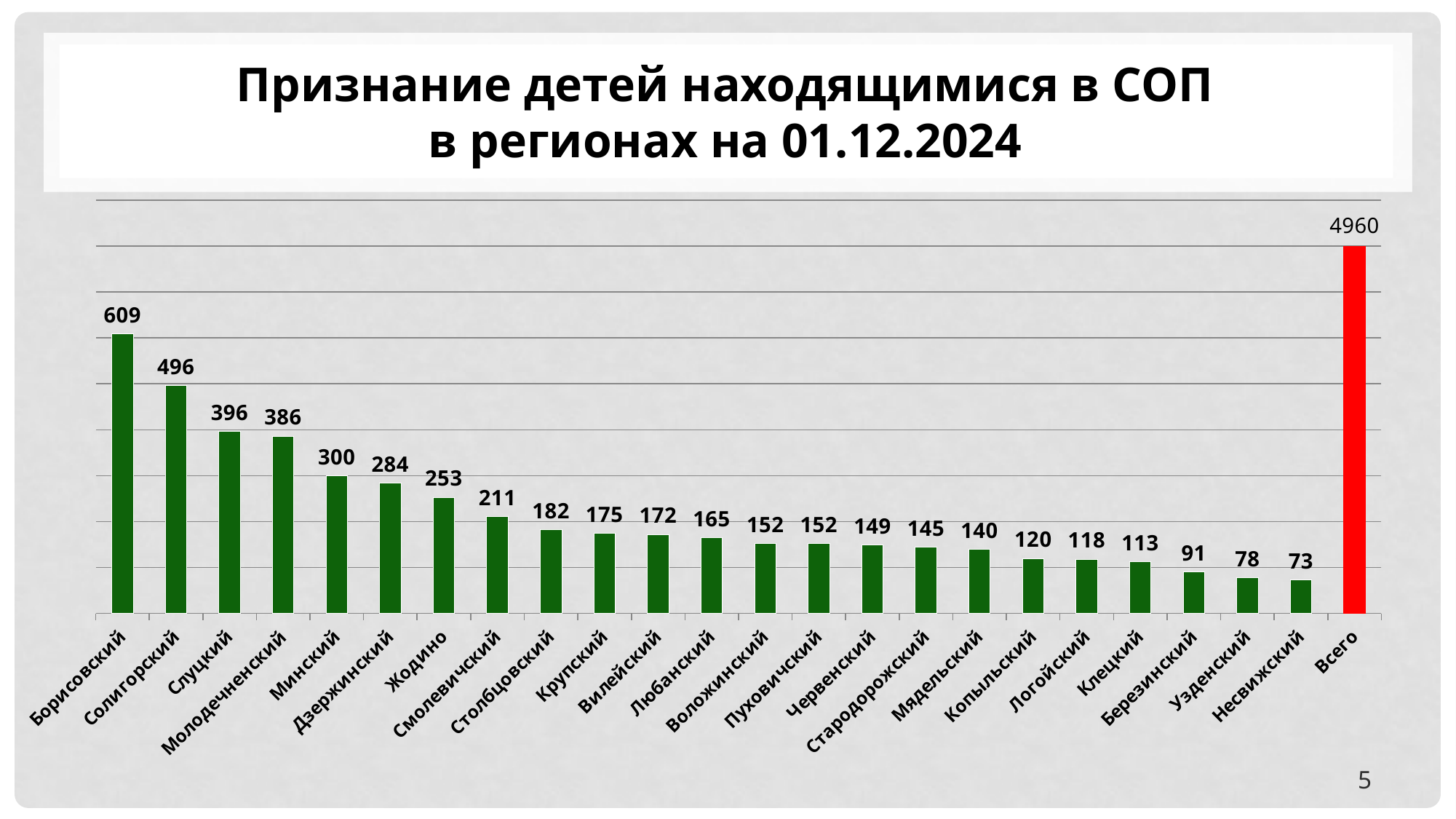
What type of chart is shown on the slide? Bar chart Which region (excluding Всего) has the highest value? Борисовский What is the value of the Всего bar? 4960 Which region has the lowest value? Несвижский Do the region values rise or fall from left to right (excluding the Всего bar)? Fall What colour is the Всего bar? Red What value is shown for Борисовский? 609 How many bars are plotted in the chart, including Всего? 24 Which has a larger value, Минский or Дзержинский? Минский What value is shown for Несвижский? 73 What is the difference between the values for Солигорский and Слуцкий? 100 What value is shown for Жодино? 253